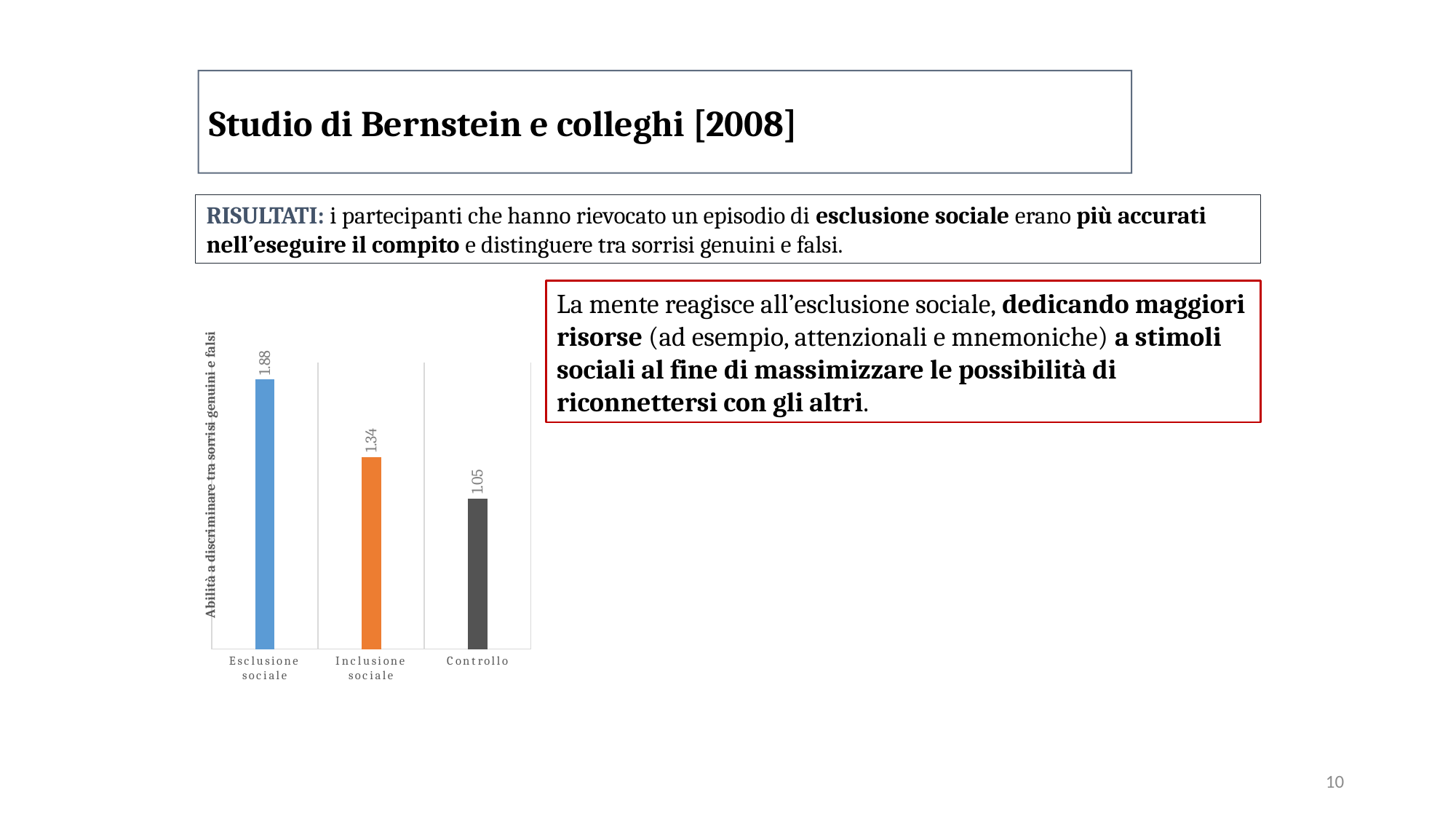
What is the label of the vertical axis of the chart? Abilità a discriminare tra sorrisi genuini e falsi What is the value for Esclusione sociale? 1.88 What is the difference between the values for Esclusione sociale and Controllo? 0.83 What is the difference between the values for Esclusione sociale and Inclusione sociale? 0.54 How many categories are shown in the chart? 3 What is the value for Controllo? 1.05 Do the values rise or fall from left to right across the categories? Fall What is the value for Inclusione sociale? 1.34 What kind of chart is shown on the slide? Bar chart Which is larger, the value for Inclusione sociale or the value for Controllo? Inclusione sociale Which category has the highest value? Esclusione sociale Which category has the lowest value? Controllo